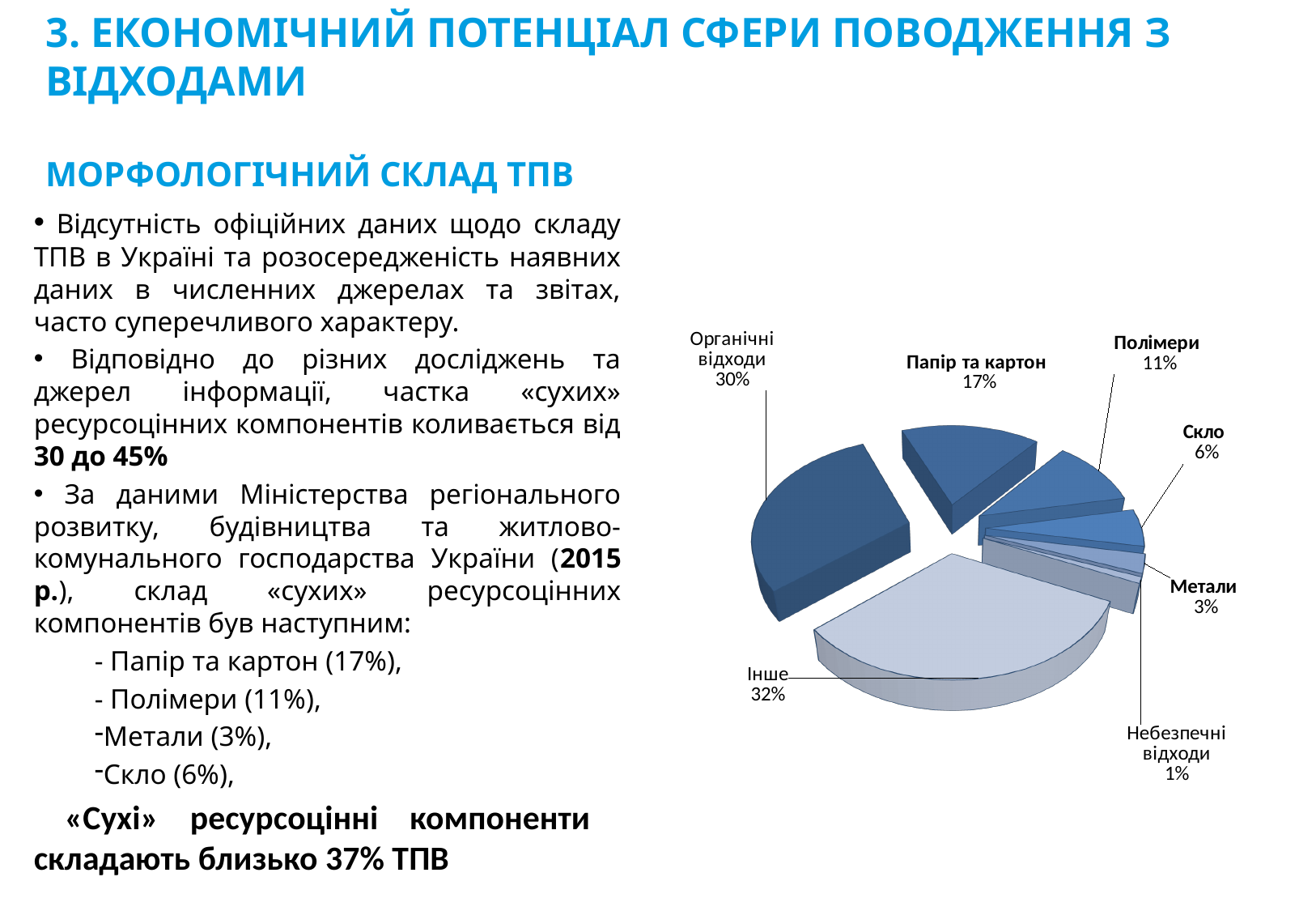
What share of the pie does "Органічні відходи" have? 30% Which is larger, the share of "Скло" or the share of "Метали"? Скло Is the share of "Органічні відходи" greater or less than 25%? greater What is the value shown for "Небезпечні відходи"? 1% What is the difference between the shares of "Інше" and "Органічні відходи"? 2% What kind of chart is shown on the slide? pie chart Which slice of the pie chart is the largest? Інше What is the value shown for "Папір та картон"? 17% How many slices does the pie chart have? 7 What is the combined share of "Папір та картон" and "Полімери"? 28% What is the value shown for "Полімери"? 11% Which slice of the pie chart is the smallest? Небезпечні відходи